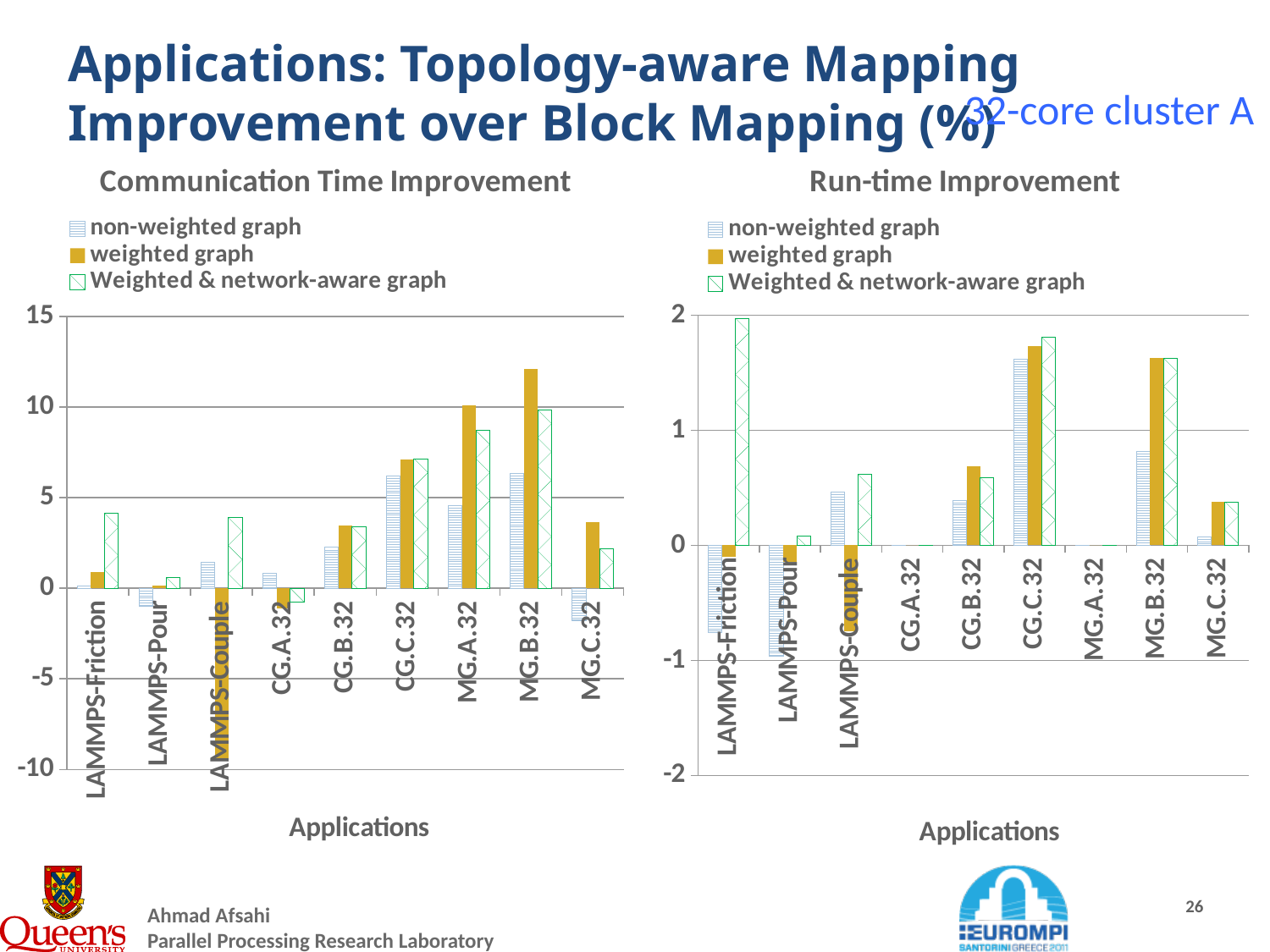
How many series does the legend of the Communication Time Improvement chart list? 3 In the Run-time Improvement chart, is the Weighted & network-aware graph value for LAMMPS-Friction greater or less than 1? greater How many applications are shown on the x axis of the Run-time Improvement chart? 9 In the Run-time Improvement chart, which application has the highest Weighted & network-aware graph bar? LAMMPS-Friction In the Communication Time Improvement chart, which application has the lowest weighted graph bar? LAMMPS-Couple What kind of chart is the Communication Time Improvement chart? bar chart In the Communication Time Improvement chart, which application has the highest weighted graph bar? MG.B.32 In the Communication Time Improvement chart, which is larger, the weighted graph value for CG.C.32 or for CG.B.32? CG.C.32 In the Communication Time Improvement chart, is the weighted graph value for LAMMPS-Couple greater or less than -5? less What is the x-axis title of the Run-time Improvement chart? Applications In the Run-time Improvement chart, which is larger, the weighted graph value for CG.B.32 or for MG.C.32? CG.B.32 In the Communication Time Improvement chart, is the weighted graph value for MG.B.32 greater or less than 10? greater